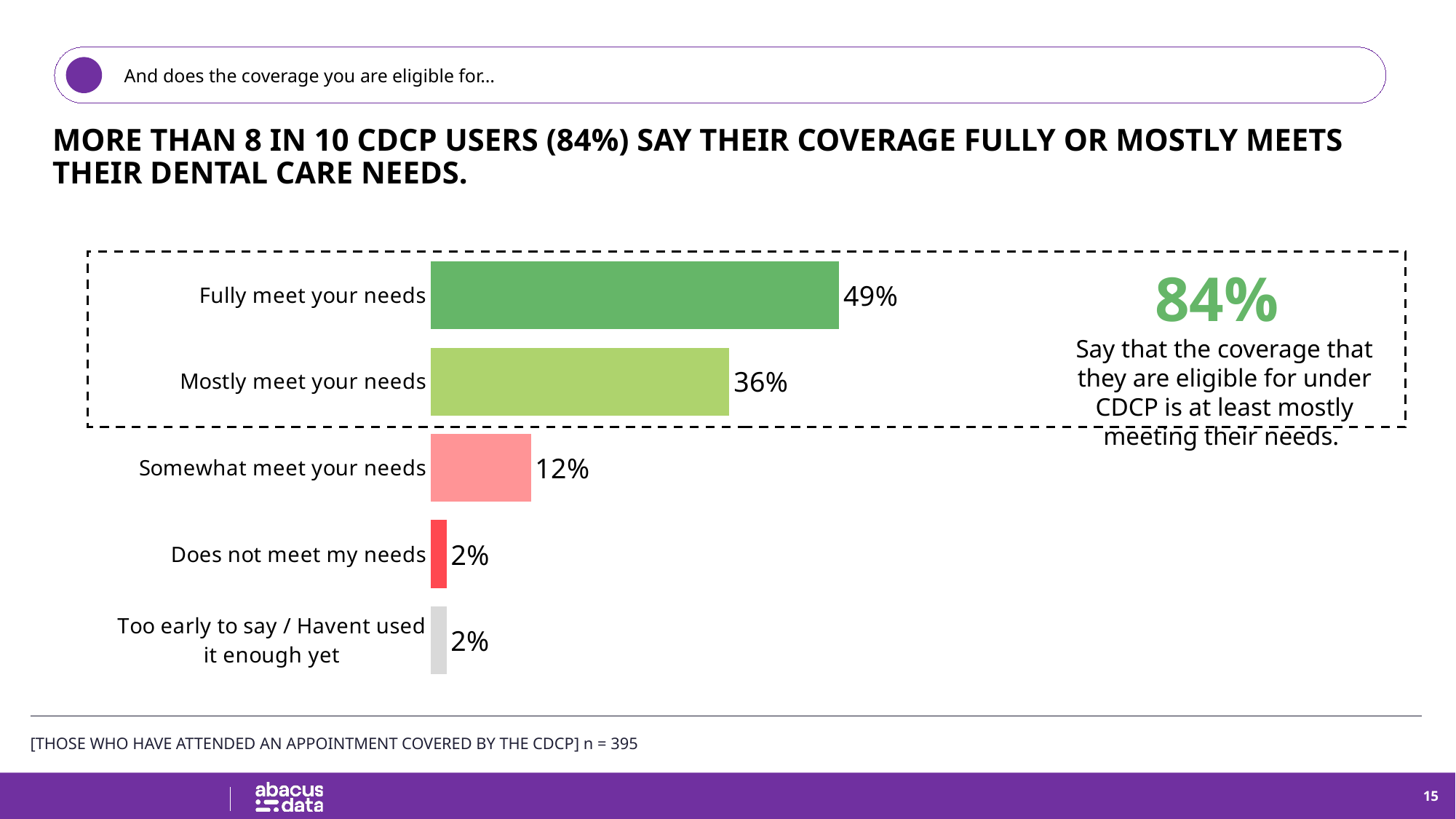
What percentage say the coverage somewhat meets their needs? 12% What type of chart is shown on the slide? Bar chart Which is larger: 'Mostly meet your needs' or 'Somewhat meet your needs'? Mostly meet your needs What percentage say the coverage mostly meets their needs? 36% Which category has the highest value in the chart? Fully meet your needs What percentage is highlighted in large green text next to the chart? 84% What is the sample size (n) noted at the bottom of the slide? 395 How many categories are shown in the chart? 5 What is the combined total of 'Fully meet your needs' and 'Mostly meet your needs'? 85% What percentage say the coverage does not meet their needs? 2% What percentage of CDCP users say the coverage fully meets their needs? 49% What is the difference between the 'Fully meet your needs' and 'Mostly meet your needs' values? 13 percentage points